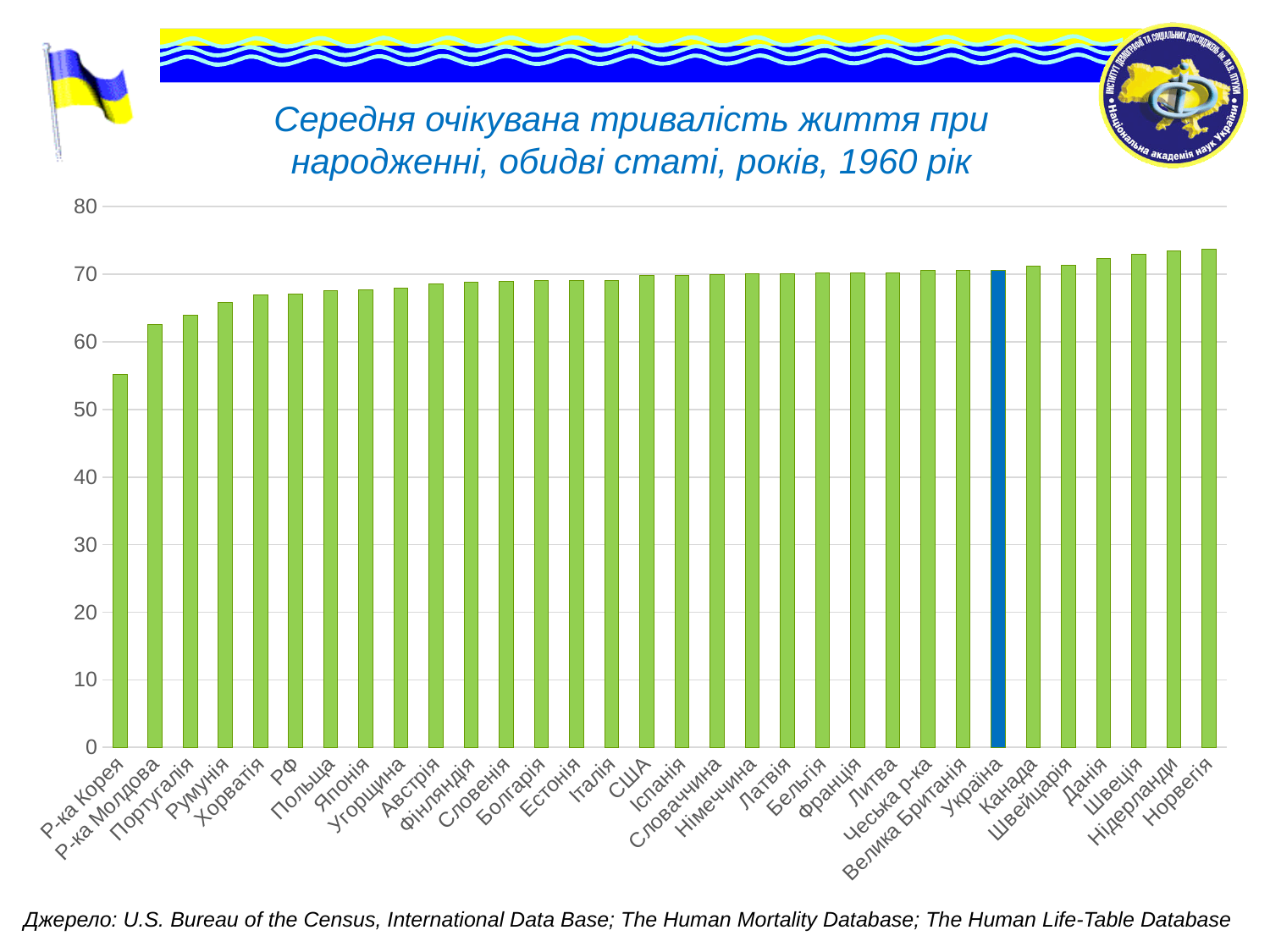
What kind of chart is shown on the slide? bar chart Is the value for Швеція greater or less than 70? greater Which has the larger value, Хорватія or Данія? Данія Is the value for Румунія greater or less than 70? less Is the value for Португалія greater or less than 60? greater Which country's bar is shown in a different colour (blue) from the others? Україна Which has the larger value, Р-ка Корея or Норвегія? Норвегія Which country has the lowest life expectancy in the chart? Р-ка Корея Do the values rise or fall from left to right along the x axis? rise How many countries are shown on the x axis of the chart? 32